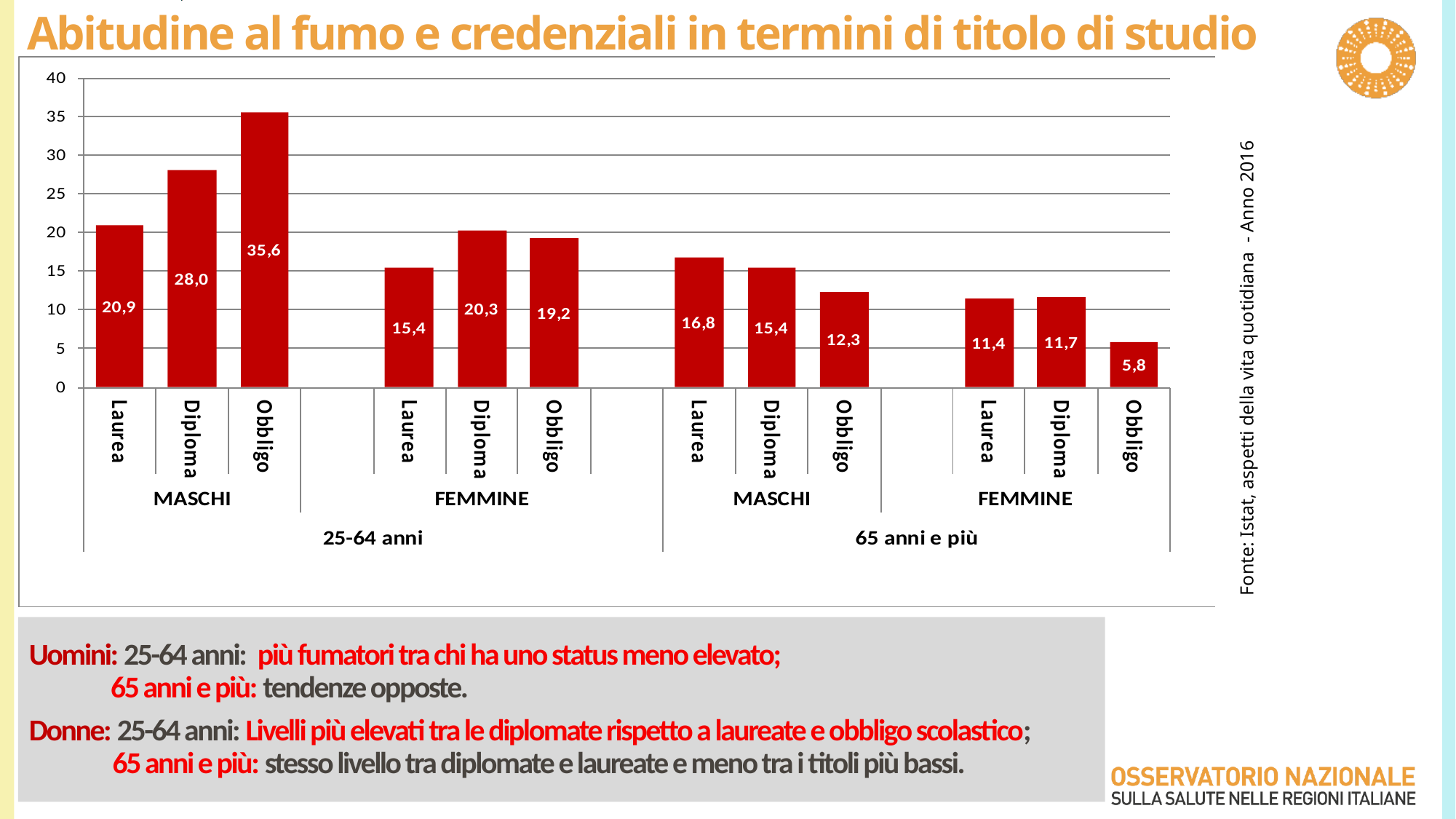
What is the value for Laurea among Maschi aged 65 anni e più? 16,8 Which is larger: Diploma among Femmine aged 25-64 anni or Diploma among Maschi aged 65 anni e più? Diploma among Femmine aged 25-64 anni What kind of chart is shown on the slide? Bar chart Which bar has the lowest value in the chart? Obbligo, Femmine, 65 anni e più What is the value for Obbligo among Maschi aged 25-64 anni? 35,6 What is the title of the chart on the slide? Abitudine al fumo e credenziali in termini di titolo di studio Do the values rise or fall from Laurea to Obbligo among Maschi aged 65 anni e più? Fall Which bar has the highest value in the chart? Obbligo, Maschi, 25-64 anni What is the value for Obbligo among Femmine aged 65 anni e più? 5,8 How many bars are plotted in the chart? 12 What is the value for Diploma among Femmine aged 25-64 anni? 20,3 What is the difference between Obbligo and Laurea among Maschi aged 25-64 anni? 14,7